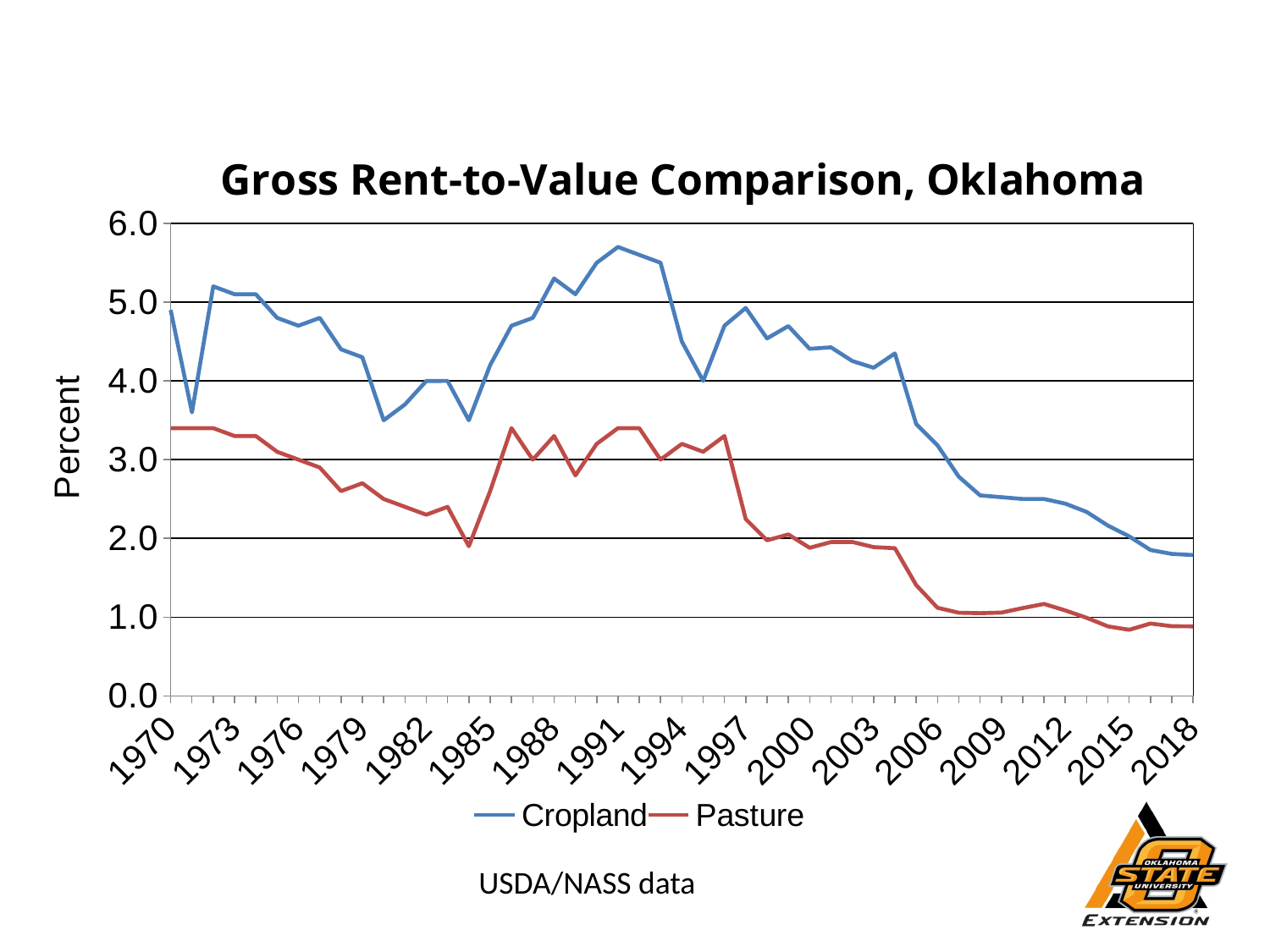
Overall, do the Pasture values rise or fall from 1970 to 2018? fall What is the title of the chart? Gross Rent-to-Value Comparison, Oklahoma Which series has the larger value in 2018, Cropland or Pasture? Cropland In which year does the Cropland series reach its highest value? 1991 Is the Cropland value for 2018 greater or less than 2.0? less Is the Cropland value for 1970 greater or less than 4.0? greater How many series does the legend list? 2 Is the Pasture value for 2018 greater or less than 1.0? less What kind of chart is shown on the slide? Line chart Which series has the larger value in 1992, Cropland or Pasture? Cropland What is the label on the vertical axis? Percent